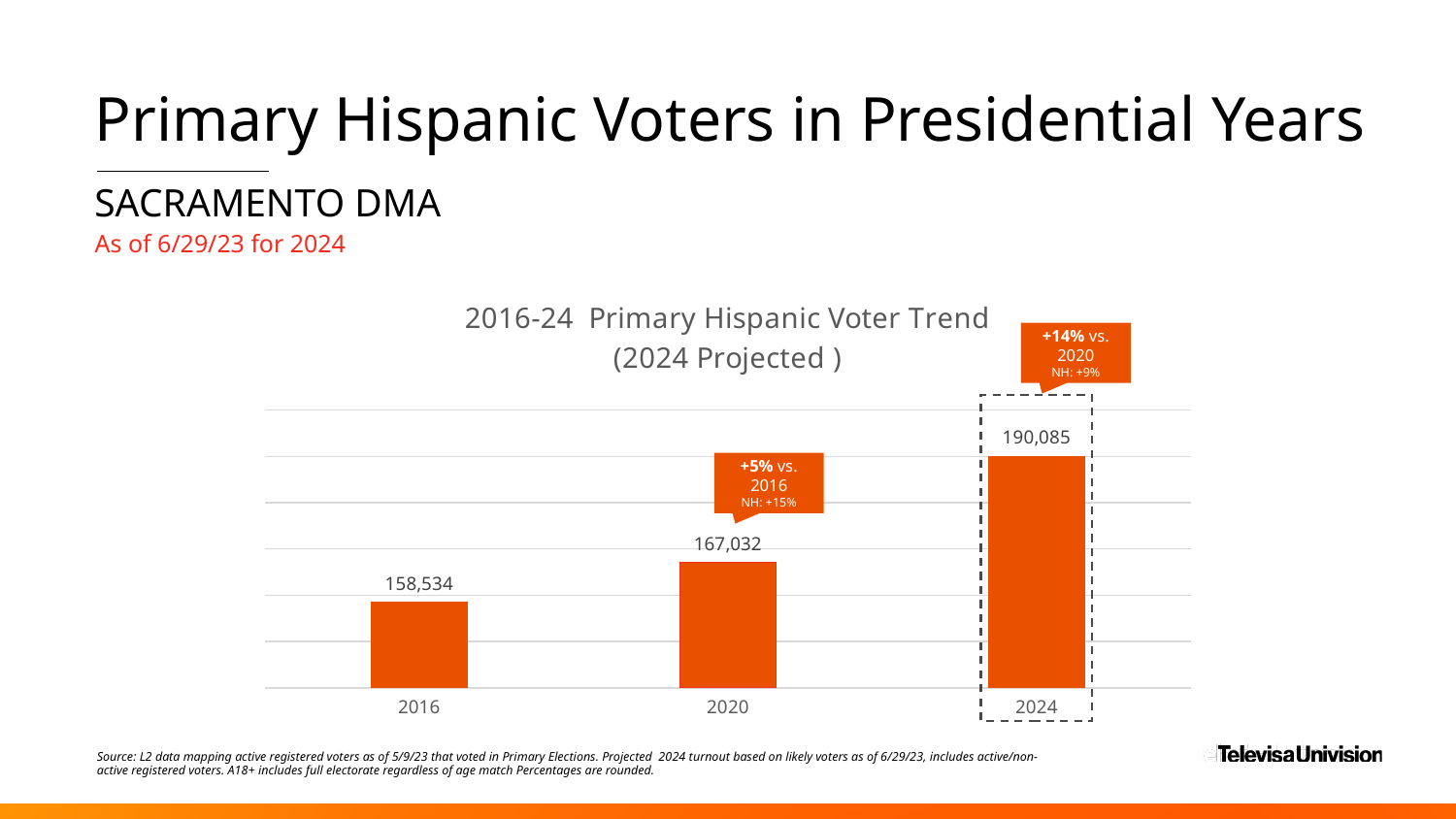
What is the title of the chart? 2016-24 Primary Hispanic Voter Trend (2024 Projected) Which is larger, the value for 2016 or the value for 2020? 2020 What is the projected value for 2024? 190,085 What is the difference between the 2024 and 2020 values? 23,053 How many years are shown on the chart? 3 What is the value for 2016? 158,534 What is the difference between the 2020 and 2016 values? 8,498 Which year has the lowest value? 2016 What is the value for 2020? 167,032 Do the values rise or fall from 2016 to 2024? rise Which year has the highest value? 2024 What kind of chart is this? bar chart